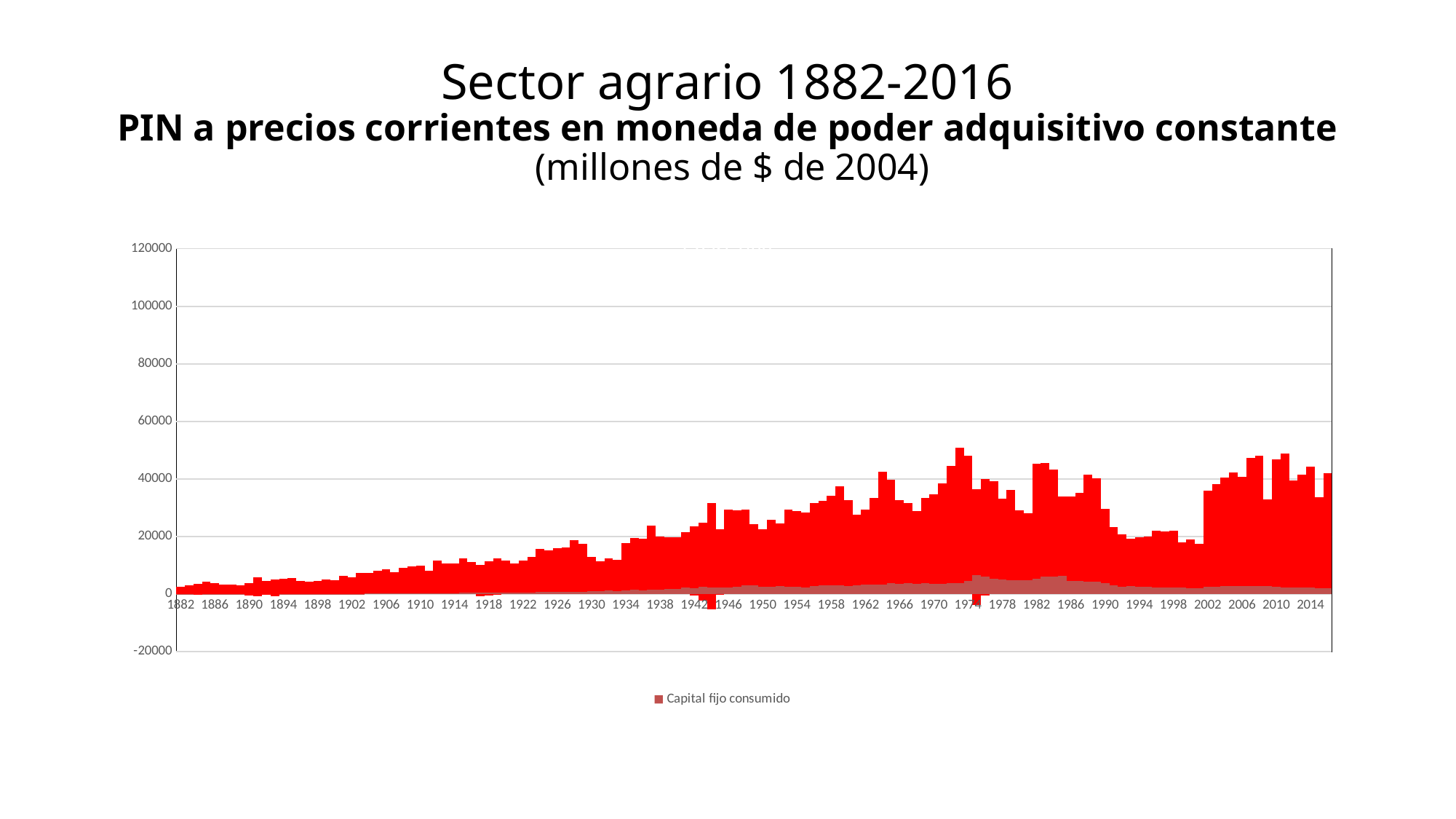
Is the value for 2008 greater or less than 40000? greater Is the value for 1962 greater or less than 20000? greater Is the value for 1974 greater or less than 40000? greater Which is larger, the value for 1974 or the value for 1994? 1974 What is the highest value shown on the chart's vertical axis? 120000 What kind of chart is shown on the slide? bar chart Overall, do the values rise or fall from 1882 to 2016? rise What series name does the chart's legend list? Capital fijo consumido